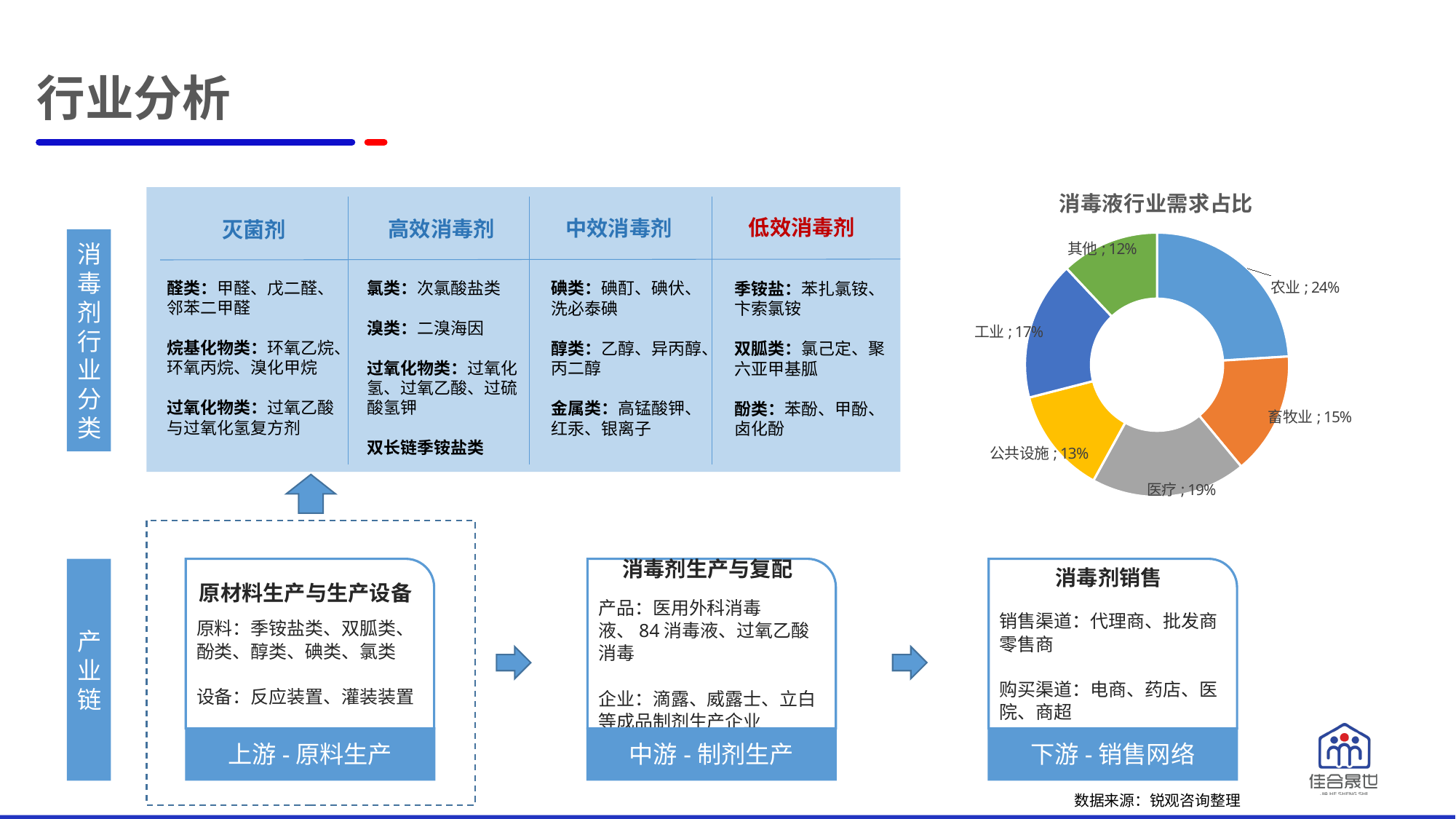
What share of demand does 农业 account for in the chart? 24% How many categories are shown in the chart? 6 What colour is the 医疗 segment in the chart? Grey Which category has the smallest share in the chart? 其他 Which category has the largest share in the chart? 农业 What share of demand does 公共设施 account for in the chart? 13% What is the title of the chart on the slide? 消毒液行业需求占比 What share of demand does 工业 account for in the chart? 17% What kind of chart is shown on the slide? Doughnut (pie) chart Which has a larger share in the chart, 医疗 or 工业? 医疗 What share of demand does 医疗 account for in the chart? 19% What is the difference in percentage points between 农业 and 畜牧业 in the chart? 9 percentage points